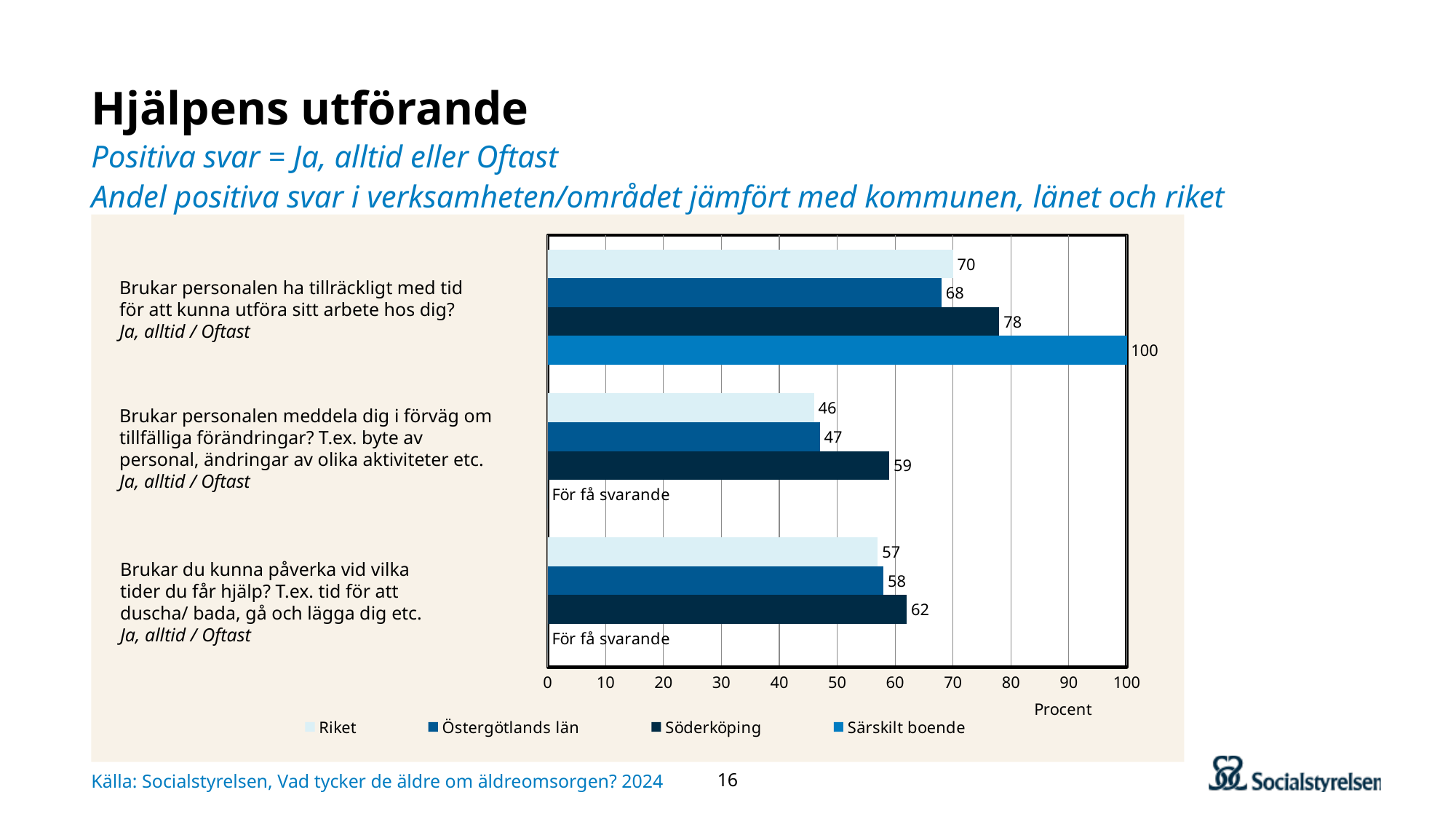
What kind of chart is shown on the slide? Bar chart How many series does the legend list? 4 How many question categories are shown on the chart? 3 Which is larger on the question "Brukar du kunna påverka vid vilka tider du får hjälp?": Söderköping or Östergötlands län? Söderköping What is the value for Östergötlands län on the question "Brukar personalen meddela dig i förväg om tillfälliga förändringar?"? 47 What text is shown in place of the Särskilt boende bar for the question "Brukar du kunna påverka vid vilka tider du får hjälp?"? För få svarande What is the value for Särskilt boende on the question "Brukar personalen ha tillräckligt med tid för att kunna utföra sitt arbete hos dig?"? 100 What is the difference between Söderköping and Riket on the question "Brukar personalen ha tillräckligt med tid för att kunna utföra sitt arbete hos dig?"? 8 Which series has the lowest value on the question "Brukar personalen meddela dig i förväg om tillfälliga förändringar?"? Riket What is the value for Riket on the question "Brukar du kunna påverka vid vilka tider du får hjälp?"? 57 Which series has the highest value on the question "Brukar personalen ha tillräckligt med tid för att kunna utföra sitt arbete hos dig?"? Särskilt boende What is the value for Söderköping on the question "Brukar personalen meddela dig i förväg om tillfälliga förändringar?"? 59